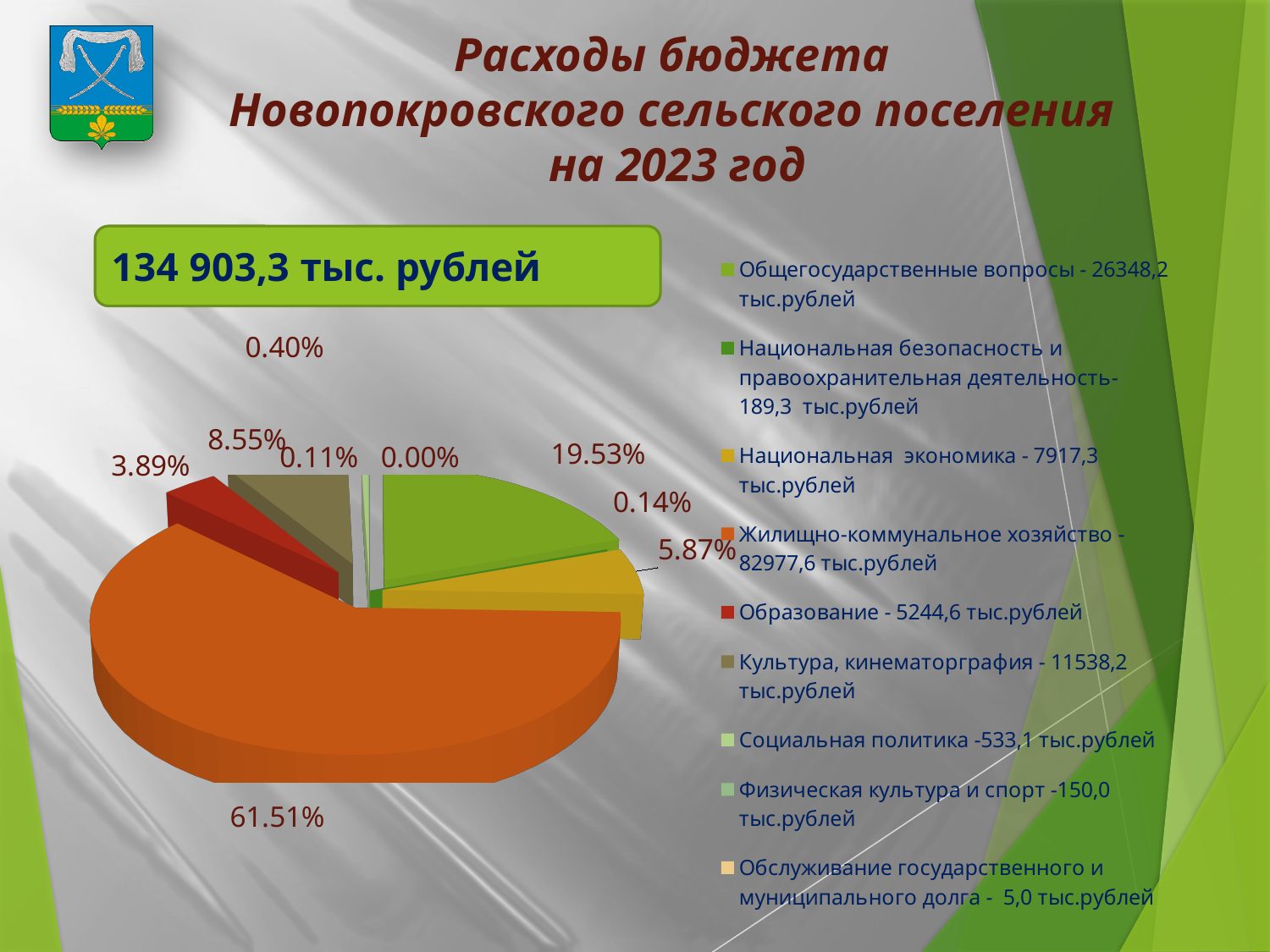
What share of the pie does Культура, кинематорграфия take? 8.55% What is the difference in percentage points between the Жилищно-коммунальное хозяйство slice (61.51%) and the Общегосударственные вопросы slice (19.53%)? 41.98 How many categories does the legend of the pie chart list? 9 Which category has the largest slice of the pie? Жилищно-коммунальное хозяйство What share of the pie does Общегосударственные вопросы take? 19.53% What share of the pie does Жилищно-коммунальное хозяйство take? 61.51% Which category has the smallest slice of the pie, labelled 0.00%? Обслуживание государственного и муниципального долга What is the value for Национальная экономика given in the legend? 7917,3 тыс.рублей Which slice is larger: Образование or Национальная экономика? Национальная экономика What kind of chart is shown on the slide? pie chart What total amount of budget expenditure is shown in the green box on the slide? 134 903,3 тыс. рублей What is the value for Образование given in the legend? 5244,6 тыс.рублей